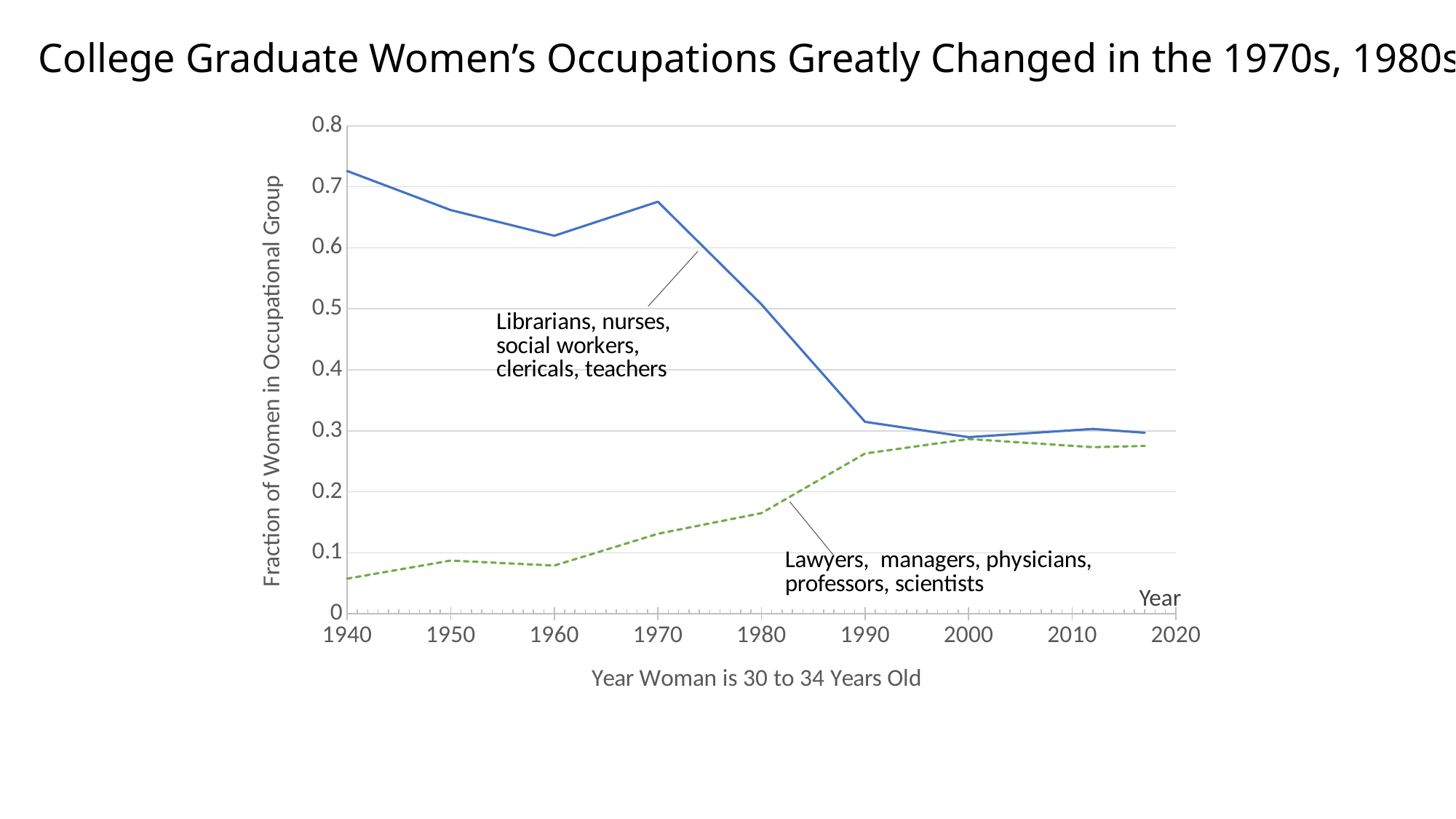
Is the 1980 value for the 'Lawyers, managers, physicians, professors, scientists' line greater or less than 0.2? less Is the 1940 value for the 'Librarians, nurses, social workers, clericals, teachers' line greater or less than 0.7? greater What is the label of the x axis of the chart? Year Woman is 30 to 34 Years Old What is the label of the y axis of the chart? Fraction of Women in Occupational Group Is the 1940 value for the 'Lawyers, managers, physicians, professors, scientists' line greater or less than 0.1? less Does the fraction of women in the 'Librarians, nurses, social workers, clericals, teachers' group rise or fall between 1940 and 1990? fall What kind of chart is shown on the slide? line chart Does the fraction of women in the 'Lawyers, managers, physicians, professors, scientists' group rise or fall between 1940 and 2000? rise How many occupational groups (lines) are plotted on the chart? 2 In 1980, which group has the larger fraction of women: 'Librarians, nurses, social workers, clericals, teachers' or 'Lawyers, managers, physicians, professors, scientists'? Librarians, nurses, social workers, clericals, teachers